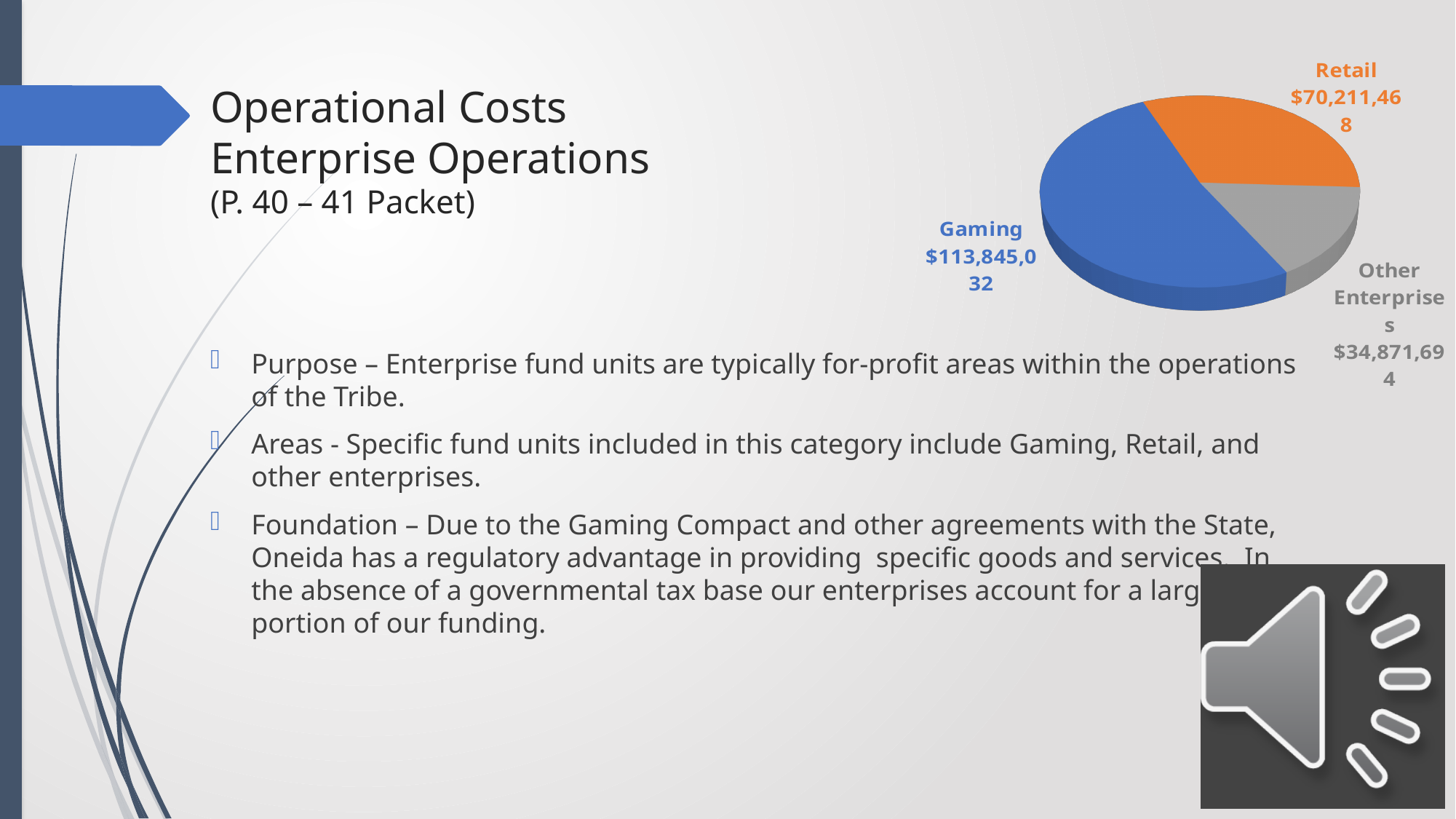
What is the value for Gaming in the pie chart? $113,845,032 What is the value for Other Enterprises in the pie chart? $34,871,694 What is the value for Retail in the pie chart? $70,211,468 How many categories are shown in the pie chart? 3 What is the total of all three values in the pie chart? $218,928,194 Which category has the smallest slice in the pie chart? Other Enterprises Which is larger in the pie chart, Retail or Other Enterprises? Retail What kind of chart is shown on the slide? Pie chart What is the difference between the Retail and Other Enterprises values in the pie chart? $35,339,774 What is the difference between the Gaming and Retail values in the pie chart? $43,633,564 What colour is the Retail slice in the pie chart? Orange Which category has the largest slice in the pie chart? Gaming